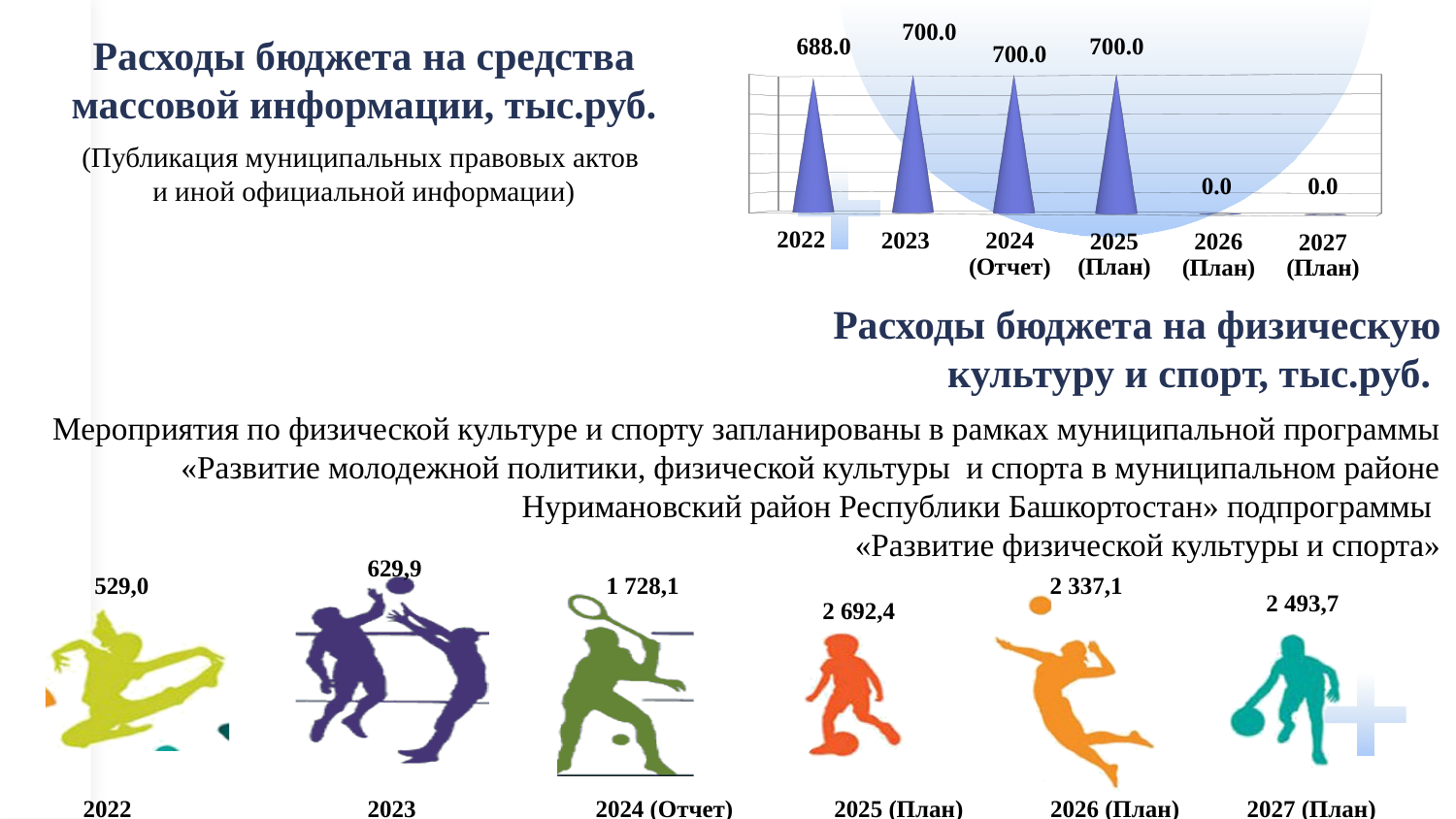
In the chart 'Расходы бюджета на физическую культуру и спорт, тыс.руб.', what is the difference between the values for 2023 and 2022? 100,9 In the chart 'Расходы бюджета на средства массовой информации, тыс.руб.', which is larger, the value for 2022 or the value for 2024 (Отчет)? 2024 (Отчет) In the chart 'Расходы бюджета на средства массовой информации, тыс.руб.', what is the value for 2022? 688.0 In the chart 'Расходы бюджета на физическую культуру и спорт, тыс.руб.', which year has the highest value? 2025 (План) In the chart 'Расходы бюджета на физическую культуру и спорт, тыс.руб.', which is larger, the value for 2026 (План) or the value for 2027 (План)? 2027 (План) In the chart 'Расходы бюджета на физическую культуру и спорт, тыс.руб.', what is the value for 2024 (Отчет)? 1 728,1 In the chart 'Расходы бюджета на средства массовой информации, тыс.руб.', how many years are shown on the x axis? 6 In the chart 'Расходы бюджета на средства массовой информации, тыс.руб.', what is the value for 2026 (План)? 0.0 In the chart 'Расходы бюджета на физическую культуру и спорт, тыс.руб.', which year has the lowest value? 2022 In the chart 'Расходы бюджета на средства массовой информации, тыс.руб.', what is the difference between the values for 2023 and 2022? 12.0 In the chart 'Расходы бюджета на средства массовой информации, тыс.руб.', do the values rise or fall from 2025 (План) to 2026 (План)? fall In the chart 'Расходы бюджета на физическую культуру и спорт, тыс.руб.', what is the value for 2027 (План)? 2 493,7